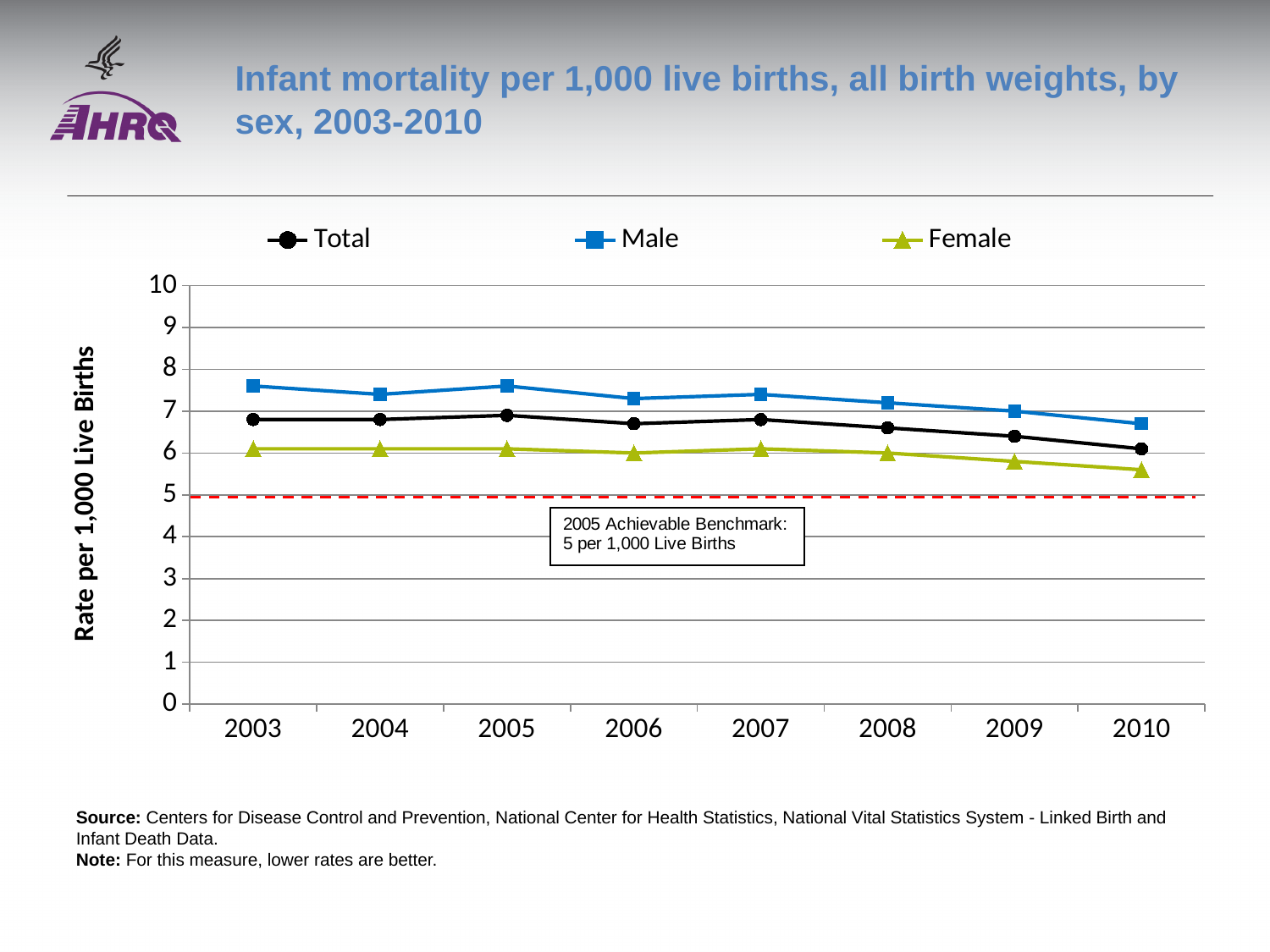
Is the Male rate in 2003 greater or less than 7? greater How many years are plotted along the x axis? 8 Which series has the highest infant mortality rate across all years? Male Is the Total rate in 2010 greater or less than 7? less In 2005, which is larger, the Male rate or the Female rate? Male What is the 2005 Achievable Benchmark shown on the chart? 5 per 1,000 Live Births What kind of chart is shown on the slide? Line chart Does the Male infant mortality rate rise or fall from 2003 to 2010? Fall Is the Female rate in 2010 greater or less than 6? less How many series does the legend list? 3 Which series has the lowest infant mortality rate across all years? Female